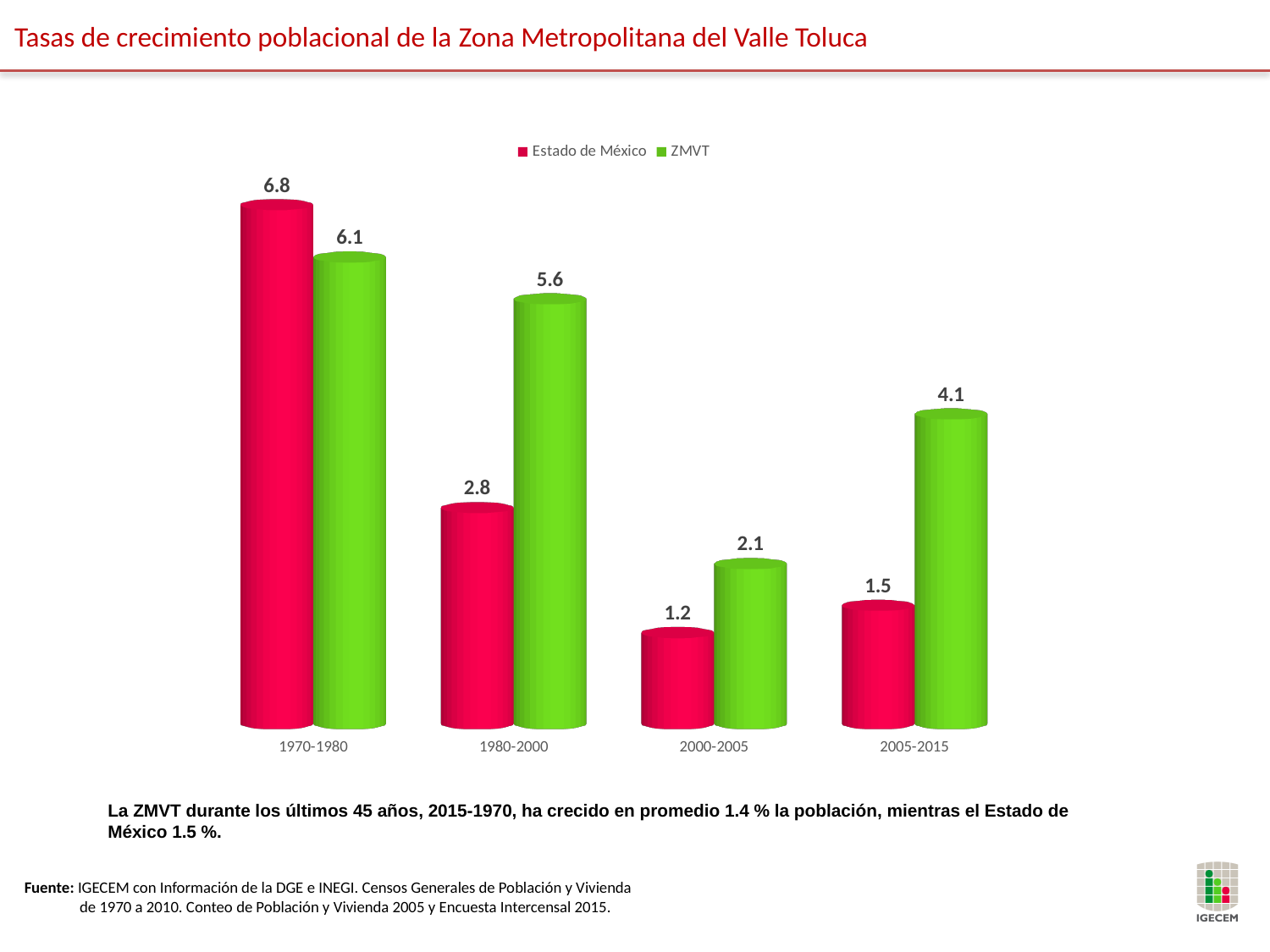
How many periods are shown on the x axis? 4 What kind of chart is shown on the slide? Bar chart Which is larger in 2005-2015, Estado de México or ZMVT? ZMVT Which period has the lowest value for ZMVT? 2000-2005 What is the value for ZMVT in 2005-2015? 4.1 Do the Estado de México values rise or fall from 1970-1980 to 2000-2005? Fall What is the value for Estado de México in 2000-2005? 1.2 What is the value for Estado de México in 1970-1980? 6.8 What is the value for ZMVT in 1980-2000? 5.6 Which period has the highest value for Estado de México? 1970-1980 What is the difference between the ZMVT and Estado de México values in 1980-2000? 2.8 How many series does the legend list? 2